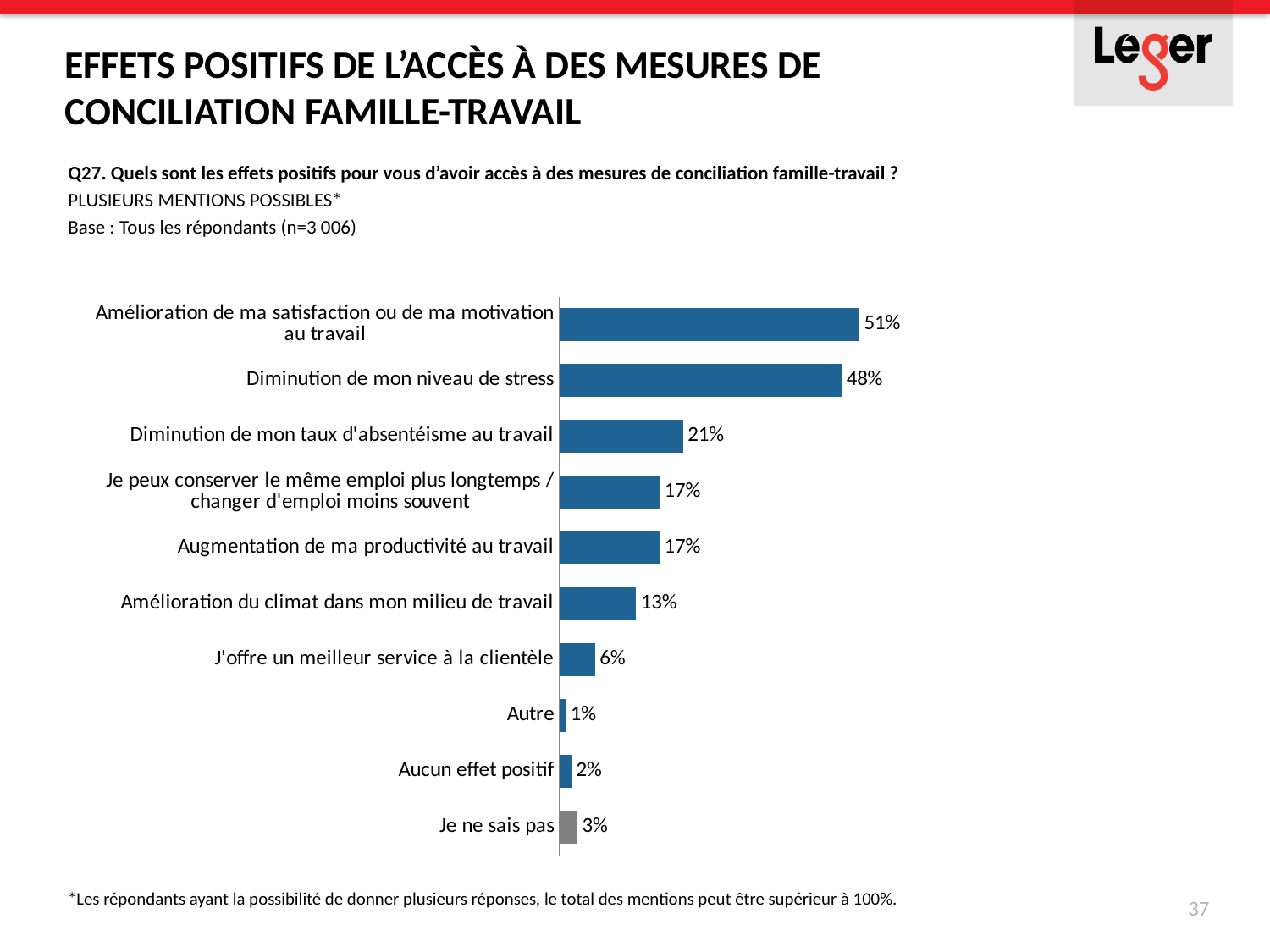
Which category has the lowest value? Autre How many categories are shown in the chart? 10 Which category has the highest value? Amélioration de ma satisfaction ou de ma motivation au travail What is the value for "Je ne sais pas"? 3% What kind of chart is shown on the slide? Bar chart Which is larger: "Aucun effet positif" or "Je ne sais pas"? Je ne sais pas What is the value for "Amélioration du climat dans mon milieu de travail"? 13% Which is larger: "Diminution de mon taux d'absentéisme au travail" or "Augmentation de ma productivité au travail"? Diminution de mon taux d'absentéisme au travail What is the difference between "Diminution de mon taux d'absentéisme au travail" and "J'offre un meilleur service à la clientèle"? 15% What is the value for "Je peux conserver le même emploi plus longtemps / changer d'emploi moins souvent"? 17% What is the value for "Diminution de mon niveau de stress"? 48% What is the difference between "Amélioration de ma satisfaction ou de ma motivation au travail" and "Diminution de mon niveau de stress"? 3%